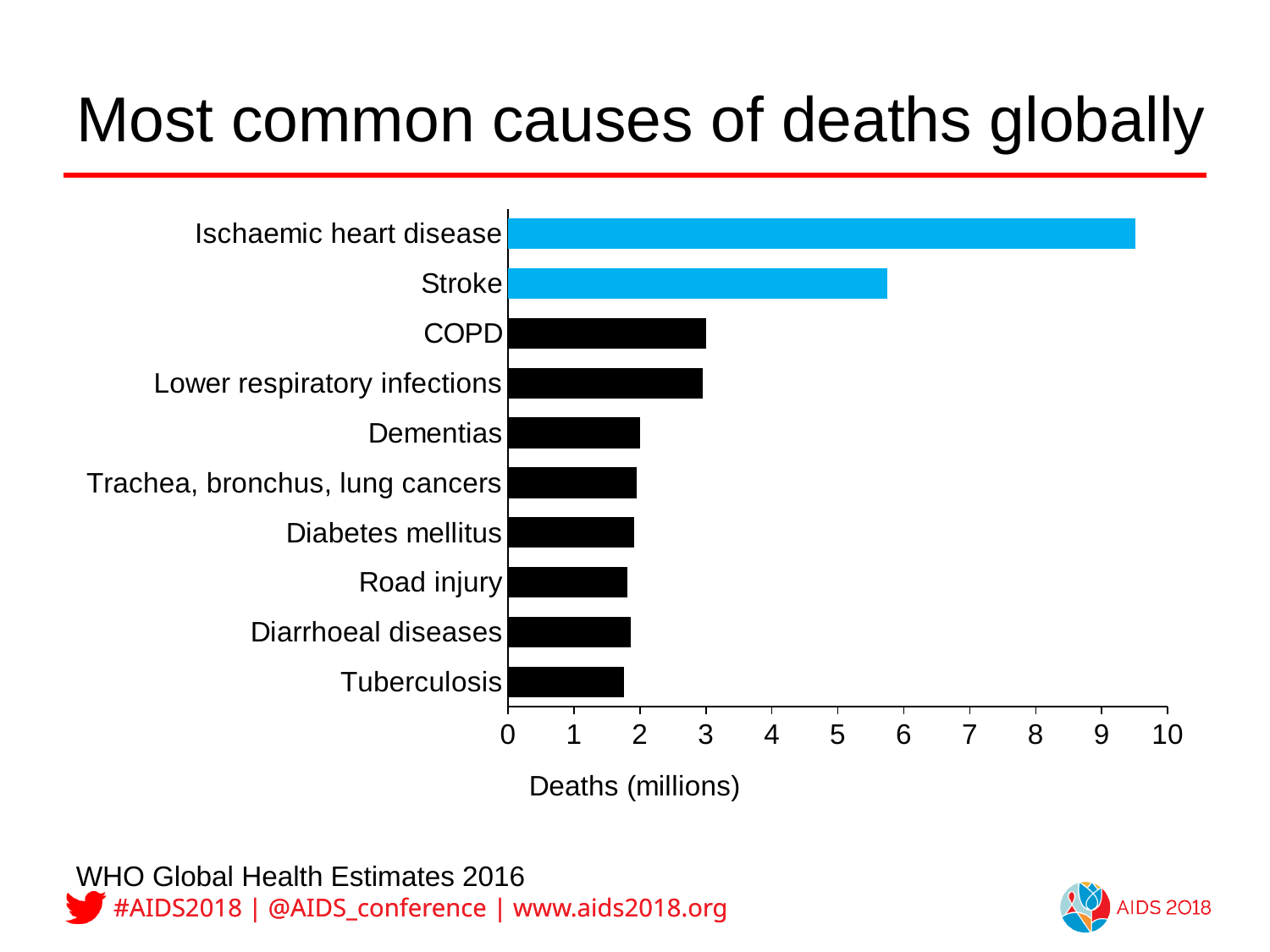
Which has more deaths, Lower respiratory infections or Tuberculosis? Lower respiratory infections Is the value for Road injury greater or less than 2 million deaths? less Is the value for Stroke greater or less than 6 million deaths? less Is the value for Stroke greater or less than 5 million deaths? greater What is the label of the horizontal axis? Deaths (millions) What kind of chart is shown on the slide? Bar chart How many causes of death are listed in the chart? 10 Which two causes of death are shown with blue bars? Ischaemic heart disease and Stroke Which cause of death has the highest number of deaths in the chart? Ischaemic heart disease Which has more deaths, Stroke or COPD? Stroke